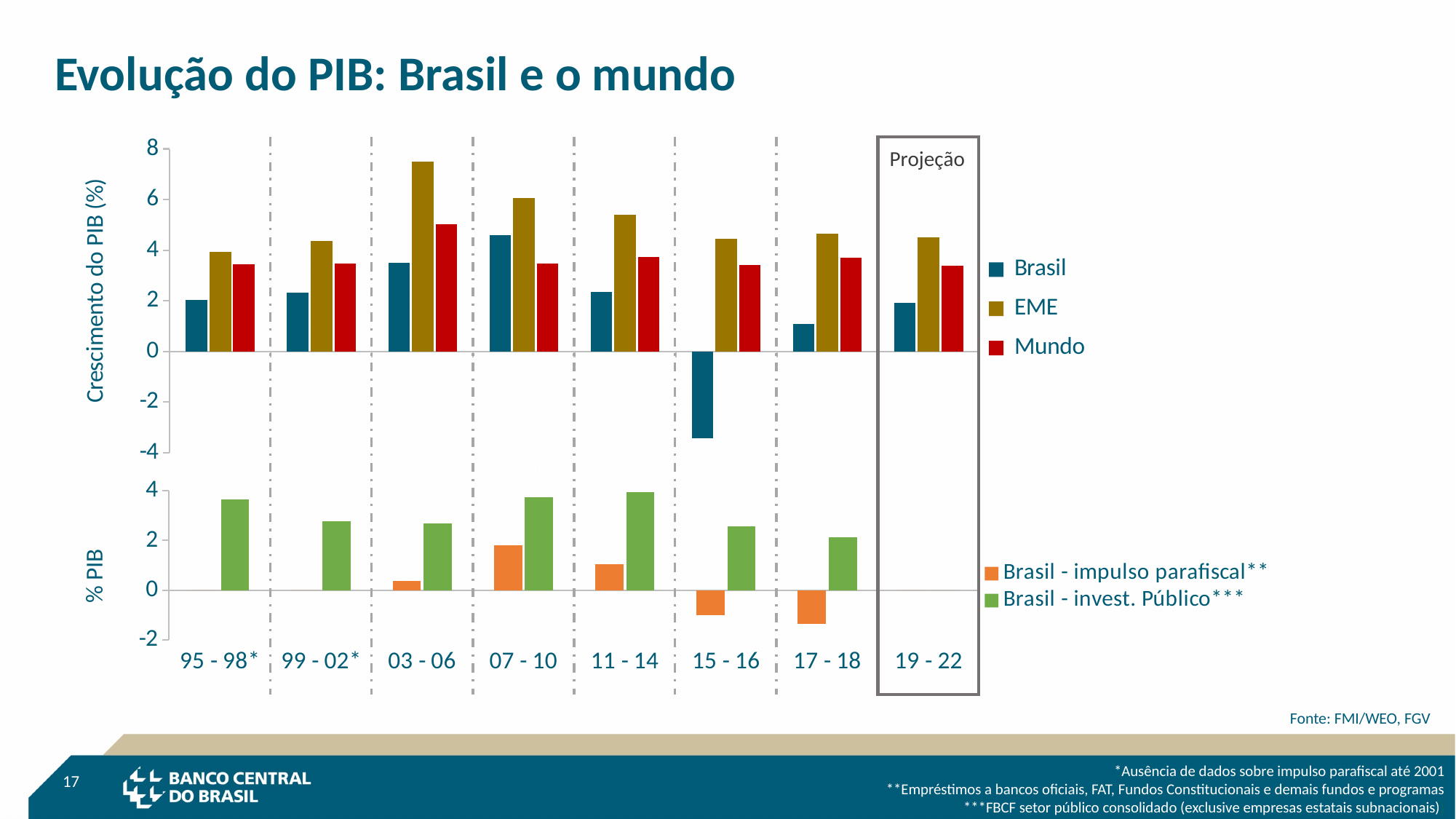
In the top chart (Crescimento do PIB), how many periods are shown on the x axis? 8 In the top chart (Crescimento do PIB), is the Brasil value for 07 - 10 greater or less than 4? greater In the bottom chart (% PIB), in how many periods is the Brasil - impulso parafiscal value negative? 2 In the top chart (Crescimento do PIB), is the Brasil value for 15 - 16 greater or less than -2? less In the top chart (Crescimento do PIB), what kind of chart is shown? bar chart In the bottom chart (% PIB), how many series does the legend list? 2 In the top chart (Crescimento do PIB), in which period is the Brasil value lowest? 15 - 16 In the top chart (Crescimento do PIB), in which period is the EME value highest? 03 - 06 In the bottom chart (% PIB), is the Brasil - invest. Público value for 15 - 16 greater or less than 2? greater In the top chart (Crescimento do PIB), which is larger in 15 - 16, Brasil or Mundo? Mundo In the top chart (Crescimento do PIB), how many series does the legend list? 3 Which period on the x axis is marked as 'Projeção'? 19 - 22